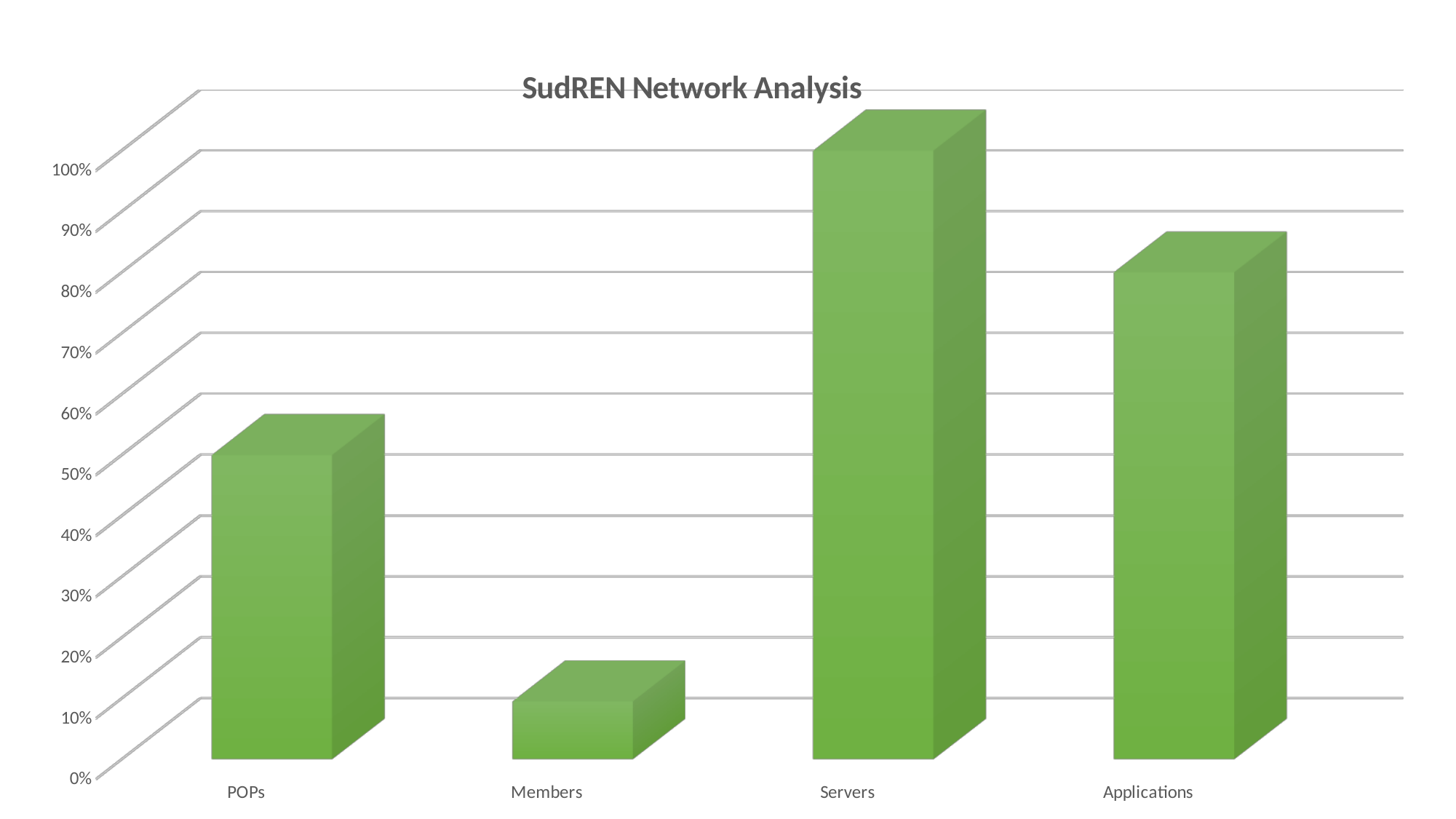
What kind of chart is shown on the slide? bar chart What is the title of the chart? SudREN Network Analysis Which is larger, the value for POPs or the value for Applications? Applications Is the value for Applications greater or less than 70%? greater Which is larger, the value for Members or the value for POPs? POPs Is the value for Servers greater or less than 90%? greater Is the value for Members greater or less than 20%? less Which category has the highest value? Servers How many categories are shown on the x axis? 4 Which category has the lowest value? Members What colour are the bars in the chart? green